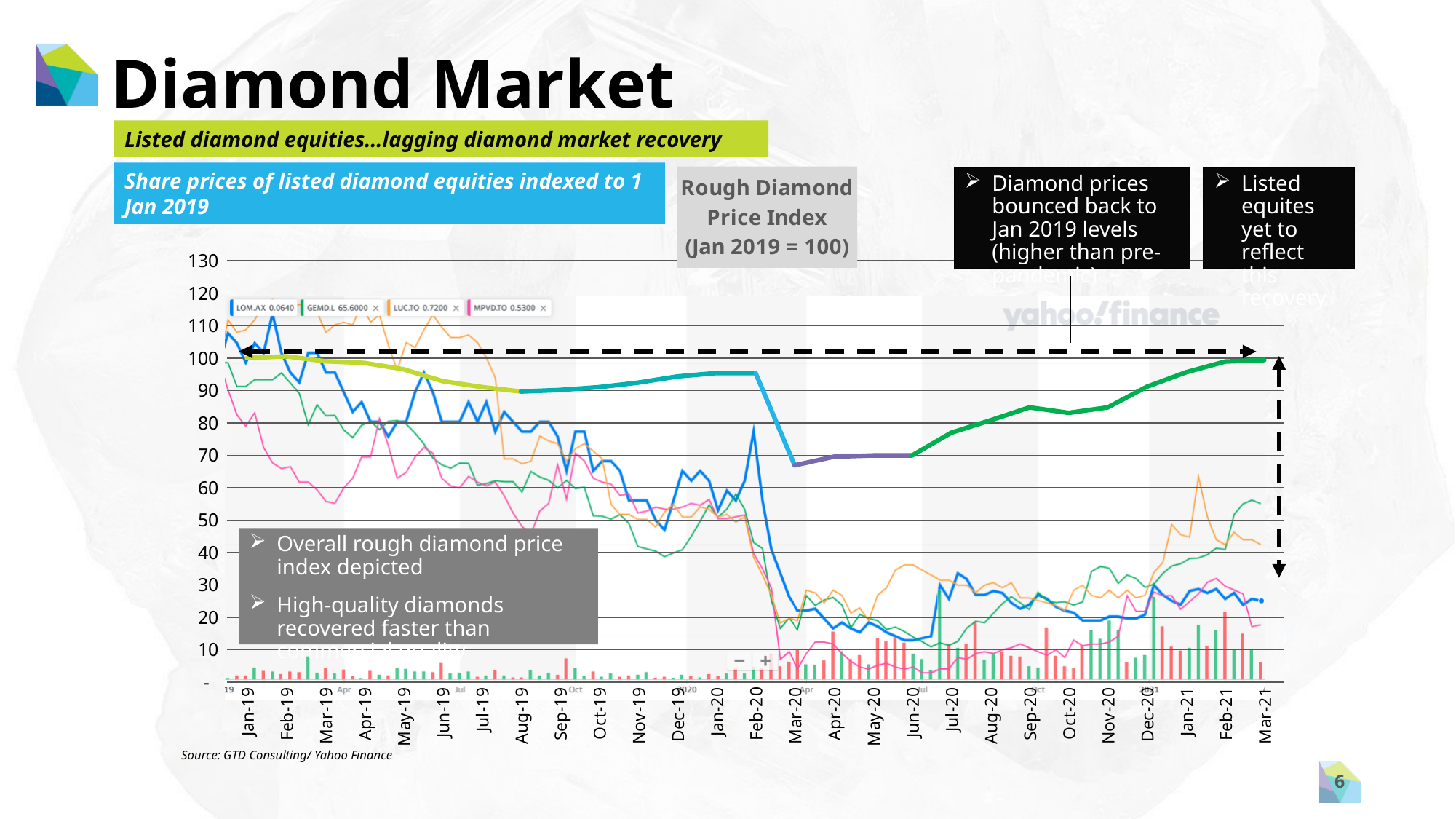
Does the Rough Diamond Price Index rise or fall between Jan-19 and Mar-20? Fall Is the Rough Diamond Price Index value for Mar-20 greater or less than 80? less What is the highest value shown on the chart's y axis? 130 Which month has a higher Rough Diamond Price Index value, Mar-20 or Sep-20? Sep-20 In which month does the Rough Diamond Price Index reach its lowest point? Mar-20 Is the Rough Diamond Price Index value for Jan-20 greater or less than 90? greater Does the Rough Diamond Price Index rise or fall between Jun-20 and Mar-21? Rise What kind of chart is used to show the Rough Diamond Price Index? Line chart Is the Rough Diamond Price Index value for Mar-21 greater or less than 90? greater How many months are labelled on the x axis of the chart, from Jan-19 to Mar-21? 27 What is the value of the Rough Diamond Price Index in Jan-19, the base month? 100